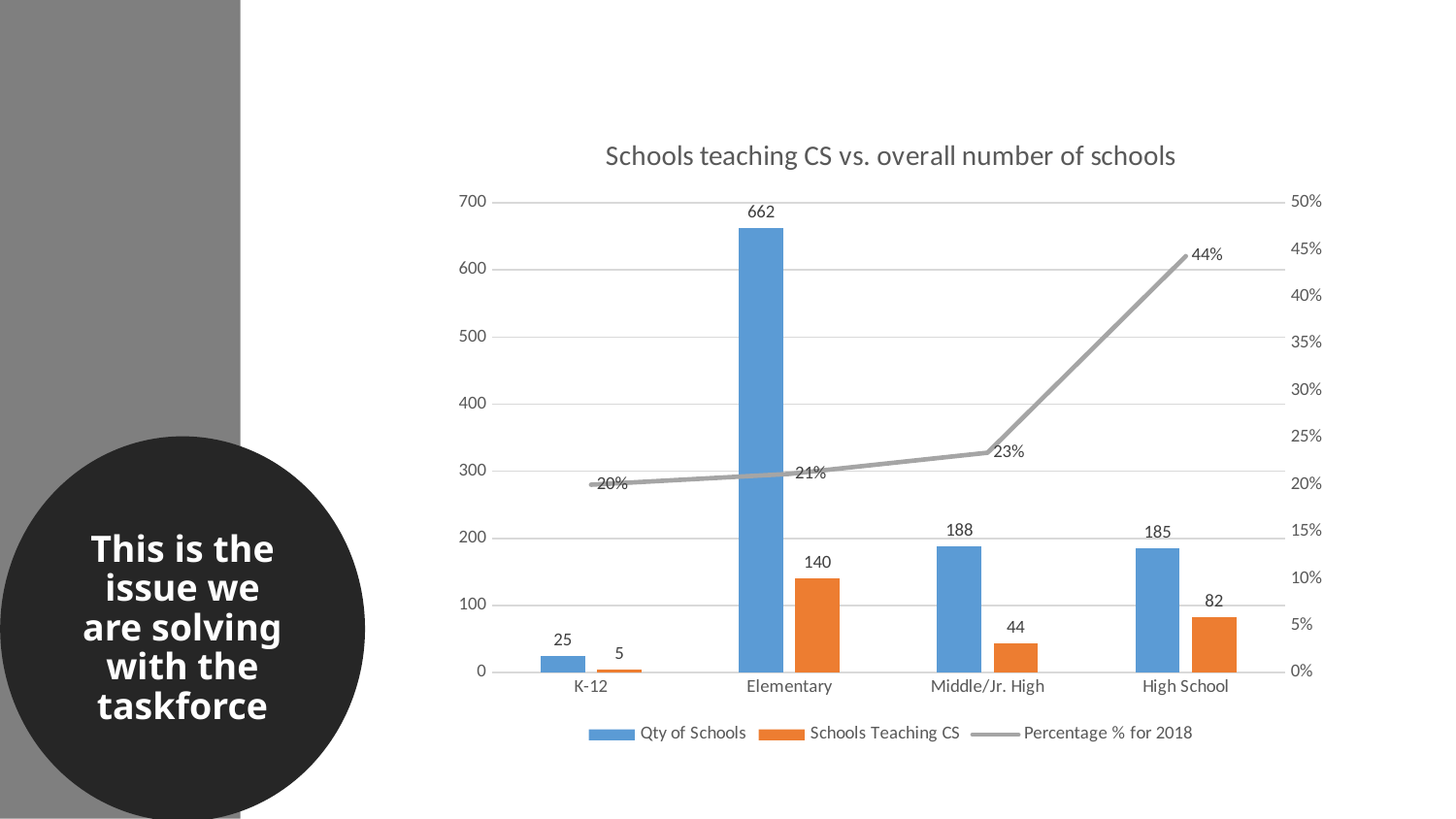
Which category has the highest Qty of Schools? Elementary What is the title of the chart? Schools teaching CS vs. overall number of schools What is the Schools Teaching CS value for High School? 82 Which category has the lowest Schools Teaching CS value? K-12 What is the Qty of Schools value for Elementary? 662 What is the difference between Qty of Schools and Schools Teaching CS for Middle/Jr. High? 144 How many categories are shown on the x axis? 4 Does the Percentage % for 2018 line rise or fall from K-12 to High School? Rise How many series does the legend list? 3 What is the Percentage % for 2018 value for Middle/Jr. High? 23% What kind of chart is this? Combined bar and line chart Which is larger, the Schools Teaching CS value for Elementary or for High School? Elementary